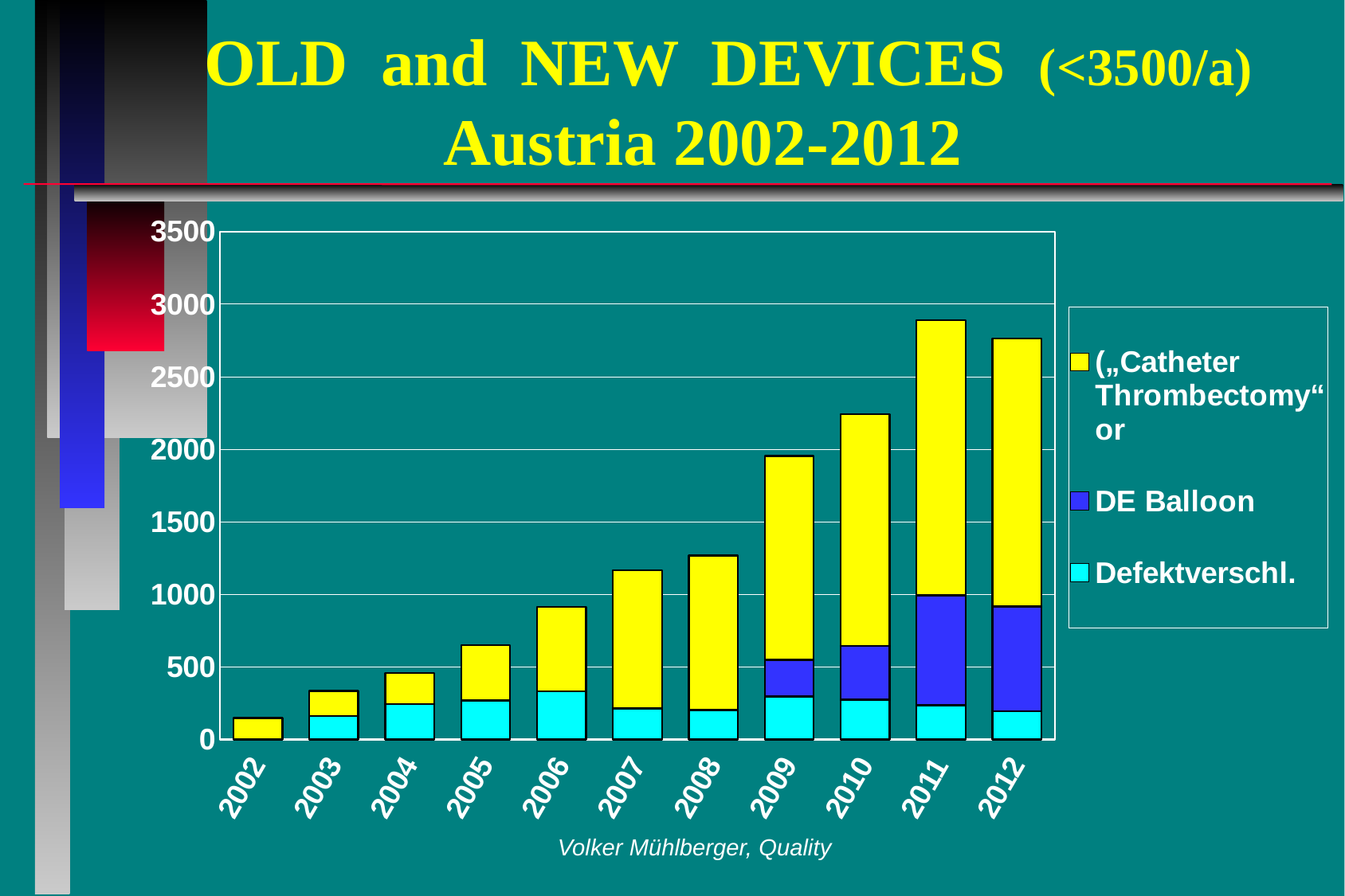
Do the total bar heights generally rise or fall from 2002 to 2011? Rise Which year has the larger total bar, 2011 or 2012? 2011 What kind of chart is shown on the slide? Stacked bar chart Which year has the shortest stacked bar in the chart? 2002 How many years are shown along the x axis of the chart? 11 How many series does the chart's legend list? 3 Which year has the tallest stacked bar in the chart? 2011 Is the total value for 2011 greater or less than 2500? greater Is the total value for 2002 greater or less than 500? less Which series is shown in dark blue in the legend? DE Balloon Is the total value for 2010 greater or less than 2000? greater